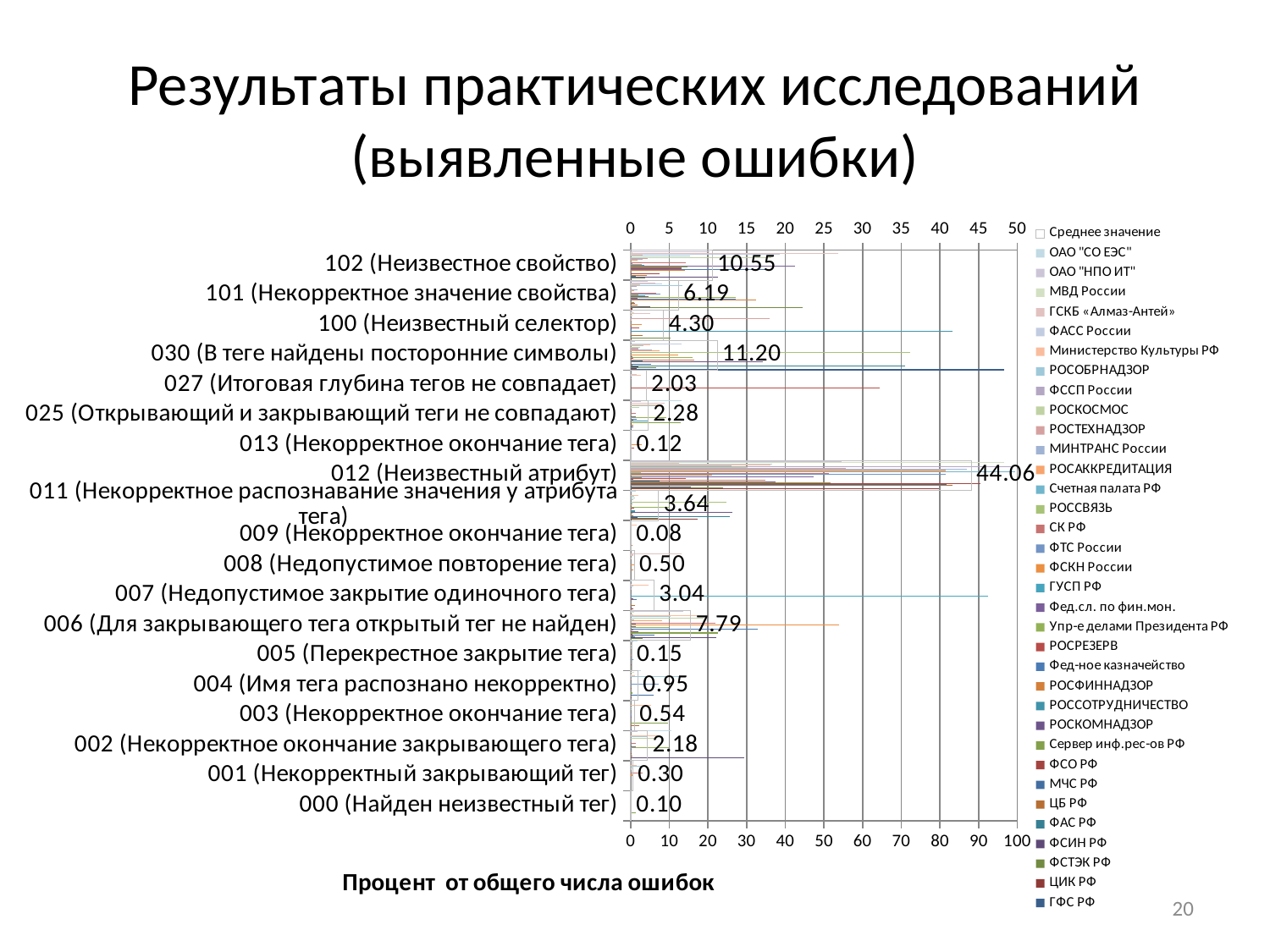
What is the title of the horizontal axis of the chart? Процент от общего числа ошибок What is the average value (Среднее значение) for error 012 (Неизвестный атрибут)? 44.06 Which error category has the lowest average value? 009 (Некорректное окончание тега) Which error category has the highest average value? 012 (Неизвестный атрибут) What is the average value shown for error 006 (Для закрывающего тега открытый тег не найден)? 7.79 Which has a larger average value: error 100 (Неизвестный селектор) or error 007 (Недопустимое закрытие одиночного тега)? 100 (Неизвестный селектор) What type of chart is shown on the slide? Bar chart What is the difference between the average values for error 102 (Неизвестное свойство) and error 101 (Некорректное значение свойства)? 4.36 How many error categories are listed on the vertical axis of the chart? 19 How many series does the chart legend list? 35 What is the average value shown for error 030 (В теге найдены посторонние символы)? 11.20 What is the average value shown for error 102 (Неизвестное свойство)? 10.55